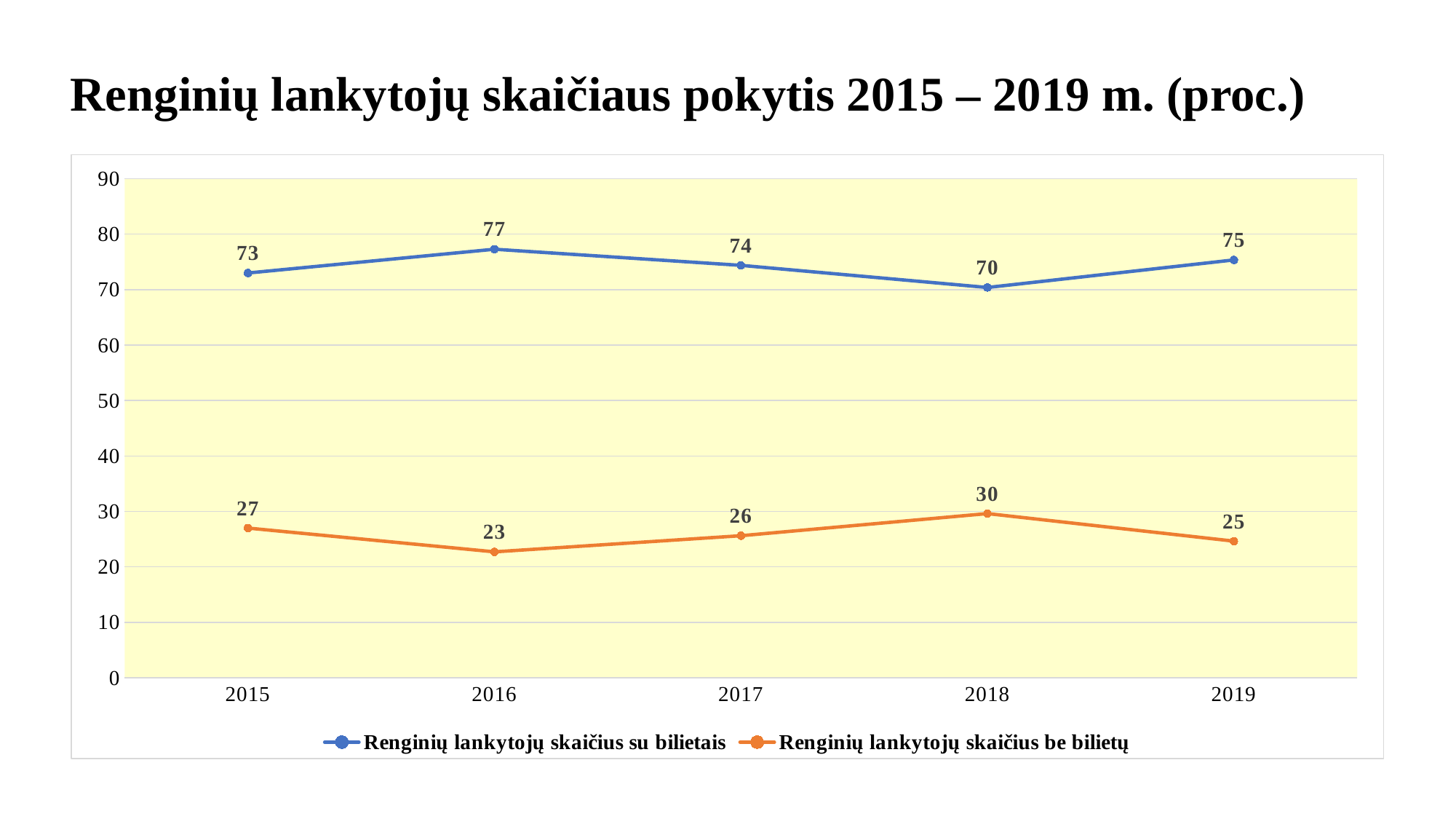
In which year is "Renginių lankytojų skaičius be bilietų" lowest? 2016 Which is larger: "Renginių lankytojų skaičius be bilietų" in 2017 or in 2019? 2017 How many series does the legend list? 2 How many years are shown on the x axis? 5 What is the difference between the two series in 2015? 46 In which year is "Renginių lankytojų skaičius su bilietais" lowest? 2018 In which year is "Renginių lankytojų skaičius be bilietų" highest? 2018 What kind of chart is shown on the slide? line chart What is the title of the slide? Renginių lankytojų skaičiaus pokytis 2015 – 2019 m. (proc.) What is the value for "Renginių lankytojų skaičius be bilietų" in 2018? 30 What is the value for "Renginių lankytojų skaičius su bilietais" in 2019? 75 What is the value for "Renginių lankytojų skaičius su bilietais" in 2016? 77